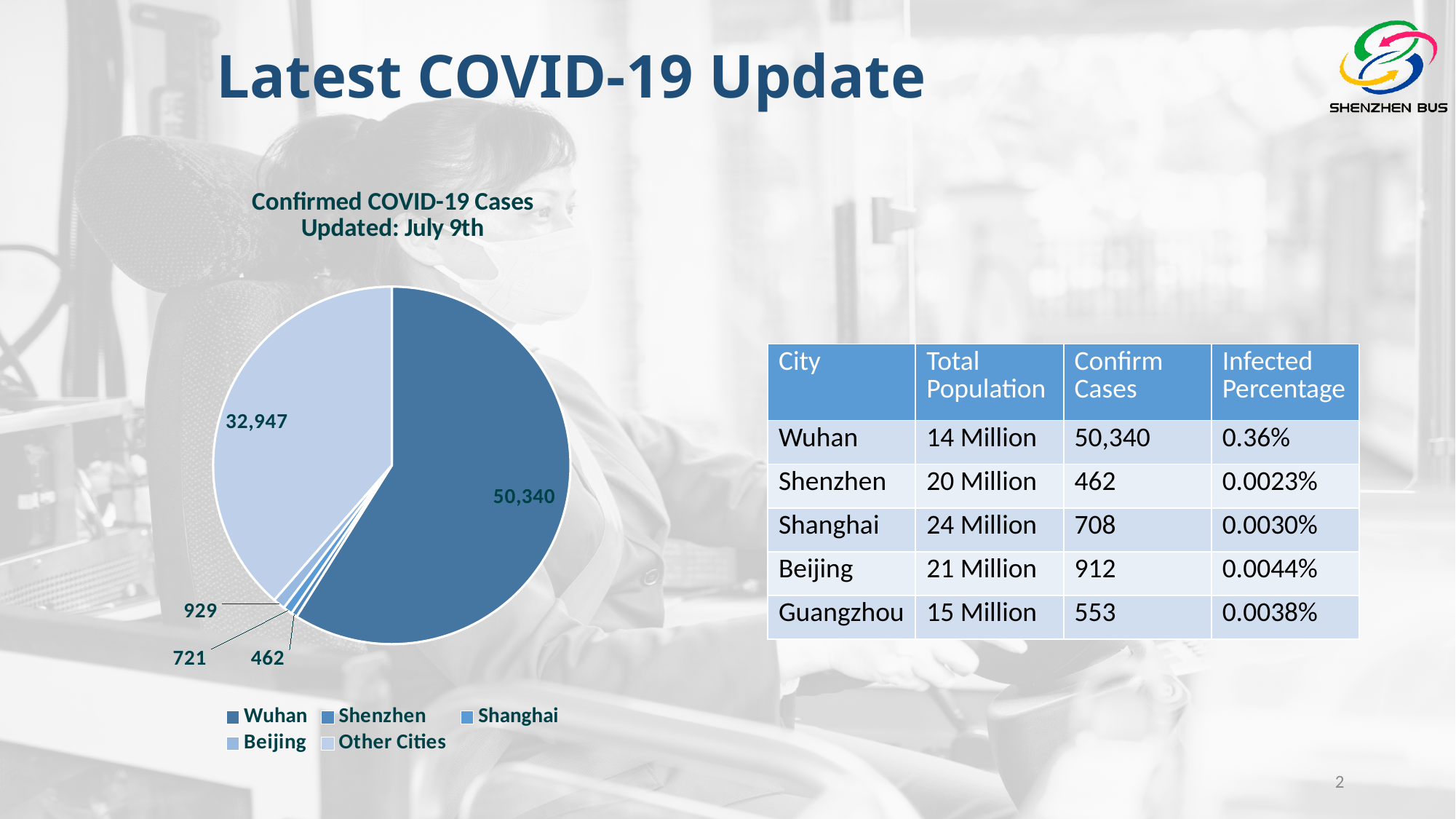
Which legend entry is listed last in the pie chart's legend? Other Cities What is the difference between the Wuhan value and the Other Cities value in the pie chart? 17,393 In the pie chart, which is larger: Wuhan or Other Cities? Wuhan Which category has the largest slice in the pie chart? Wuhan What value is shown for Wuhan in the pie chart? 50,340 How many entries does the pie chart's legend list? 5 Which category has the smallest slice in the pie chart? Shenzhen What value is shown for Other Cities in the pie chart? 32,947 What value is shown for Shenzhen in the pie chart? 462 What is the title of the pie chart? Confirmed COVID-19 Cases Updated: July 9th What kind of chart is shown on the slide? pie chart How many slices does the pie chart have? 5